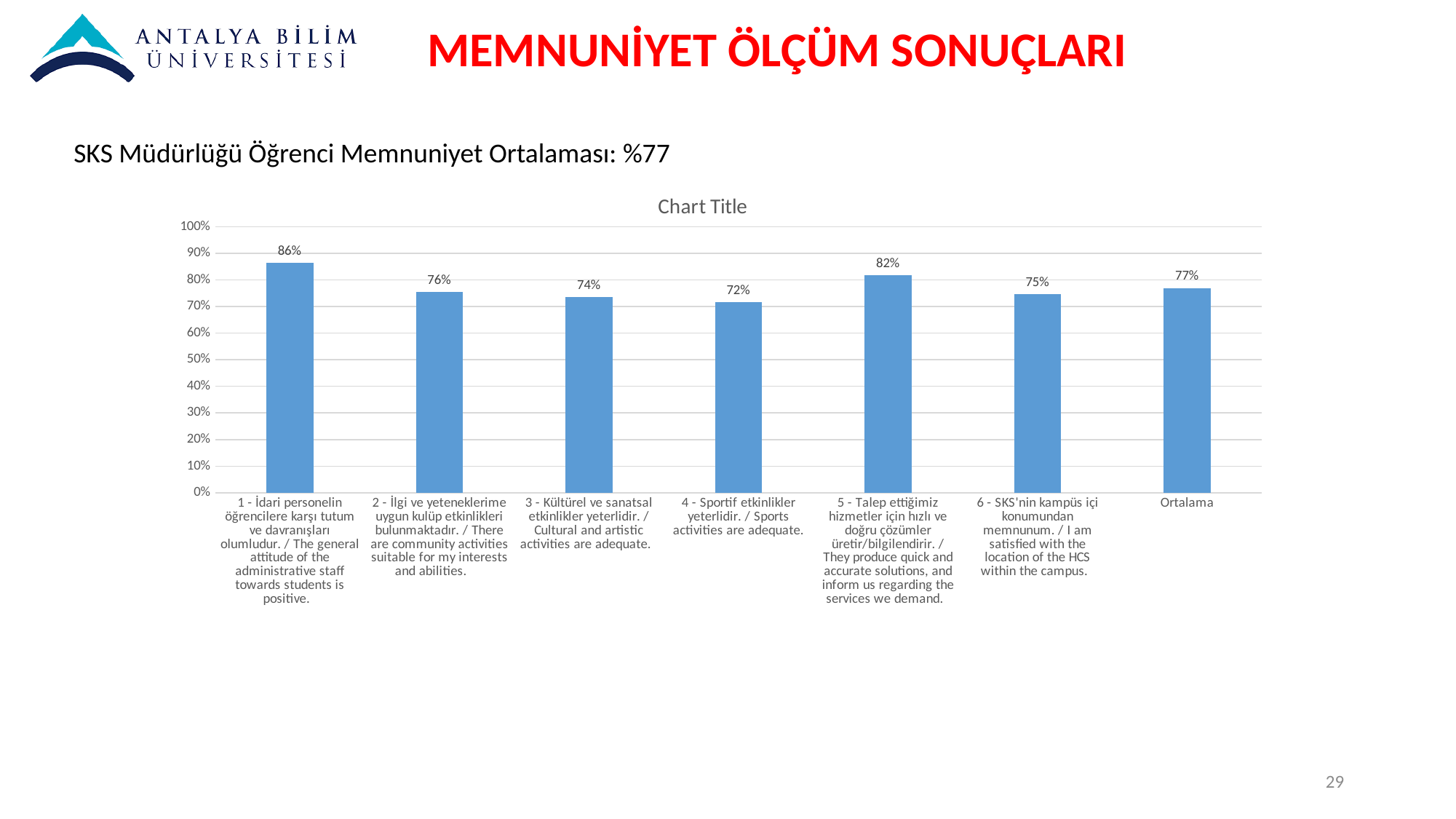
What is the value for category 4 (Sportif etkinlikler yeterlidir)? 72% What kind of chart is shown on the slide? Bar chart Which is larger, the value for category 2 or the value for category 3? Category 2 (76%) Which category has the highest value? 1 - İdari personelin öğrencilere karşı tutum ve davranışları olumludur. Which category has the lowest value? 4 - Sportif etkinlikler yeterlidir. What is the value for the Ortalama bar? 77% What is the value for category 1 (İdari personelin öğrencilere karşı tutum ve davranışları olumludur)? 86% How many bars are shown in the chart? 7 What is the value for category 5 (Talep ettiğimiz hizmetler için hızlı ve doğru çözümler üretir/bilgilendirir)? 82% What is the difference between the values for category 1 and category 4? 14% What is the title shown above the chart? Chart Title What is the difference between the values for category 5 and category 6? 7%